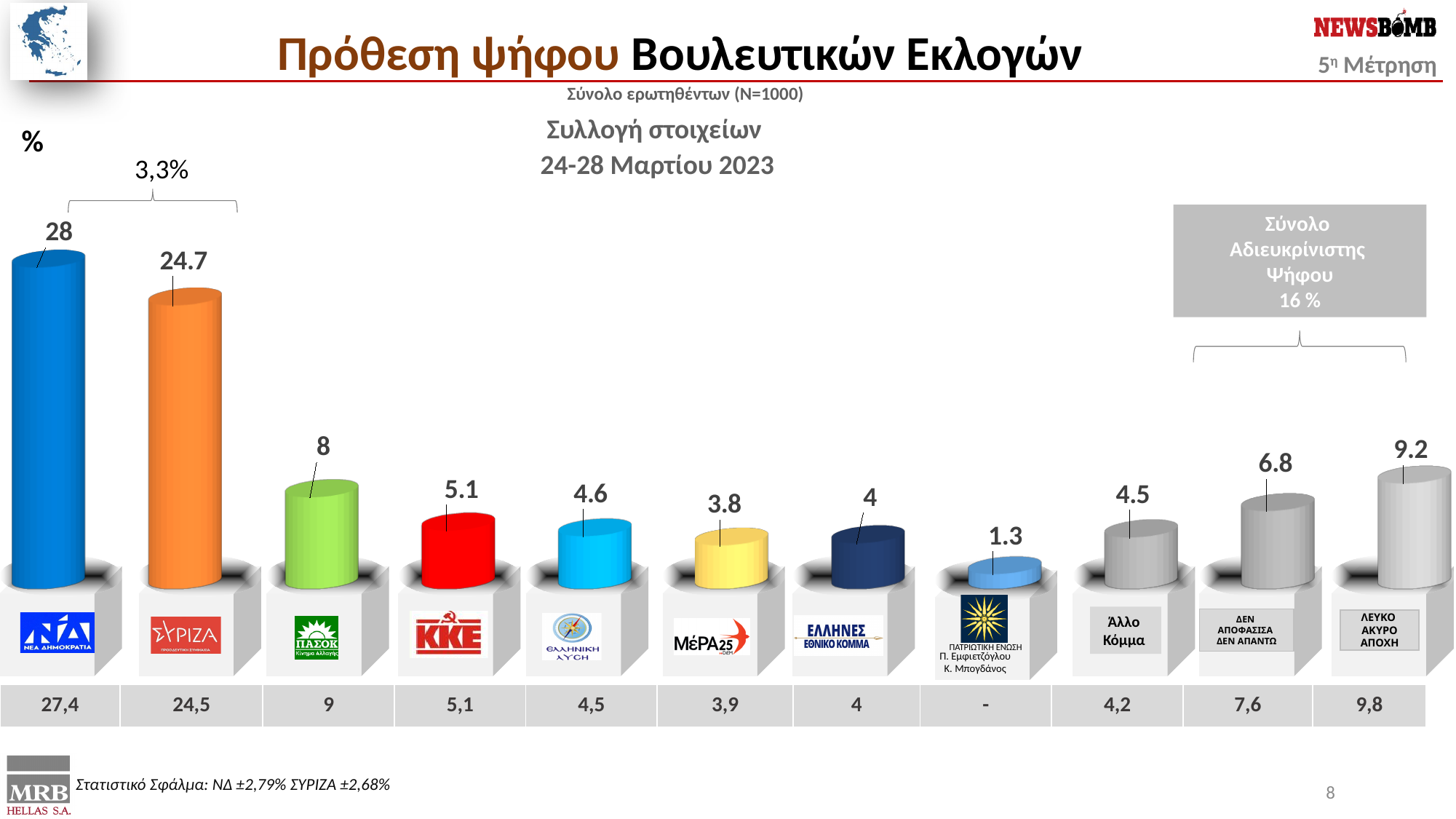
Which party has the highest value in the chart? ΝΕΑ ΔΗΜΟΚΡΑΤΙΑ What is the value shown in the grey box for Σύνολο Αδιευκρίνιστης Ψήφου? 16 % What is the value for ΝΕΑ ΔΗΜΟΚΡΑΤΙΑ? 28 Which is larger, the value for ΕΛΛΗΝΙΚΗ ΛΥΣΗ or the value for ΜέΡΑ25? ΕΛΛΗΝΙΚΗ ΛΥΣΗ What is the value for ΠΑΣΟΚ? 8 What is the value for ΣΥΡΙΖΑ? 24.7 Which category has the lowest value in the chart? ΠΑΤΡΙΩΤΙΚΗ ΕΝΩΣΗ What is the value for ΛΕΥΚΟ ΑΚΥΡΟ ΑΠΟΧΗ? 9.2 What is the value for ΚΚΕ? 5.1 What kind of chart is shown on the slide? bar chart How many categories (bars) are shown in the chart? 11 What is the difference between the values for ΝΕΑ ΔΗΜΟΚΡΑΤΙΑ and ΣΥΡΙΖΑ? 3.3